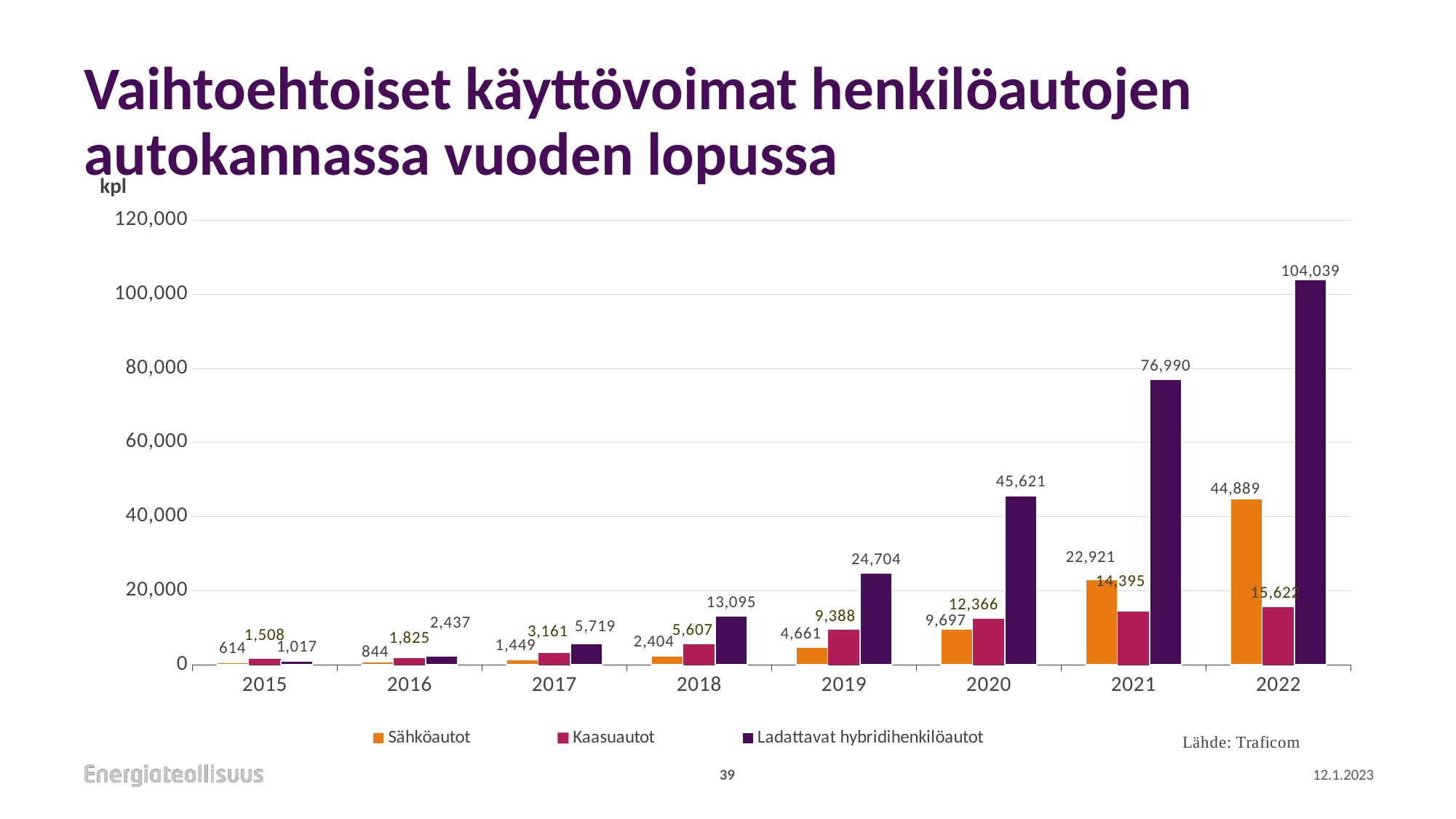
Which is larger in 2020: Sähköautot or Kaasuautot? Kaasuautot What is the value for Kaasuautot in 2019? 9,388 In which year is the value for Ladattavat hybridihenkilöautot highest? 2022 How many years are shown on the x axis? 8 What is the value for Sähköautot in 2021? 22,921 What is the difference between Ladattavat hybridihenkilöautot and Sähköautot in 2022? 59,150 What kind of chart is shown on the slide? Bar chart What is the value for Ladattavat hybridihenkilöautot in 2022? 104,039 In which year is the value for Kaasuautot lowest? 2015 Is the value for Ladattavat hybridihenkilöautot in 2021 greater or less than 80,000? less What is the value for Sähköautot in 2015? 614 How many series does the legend list? 3